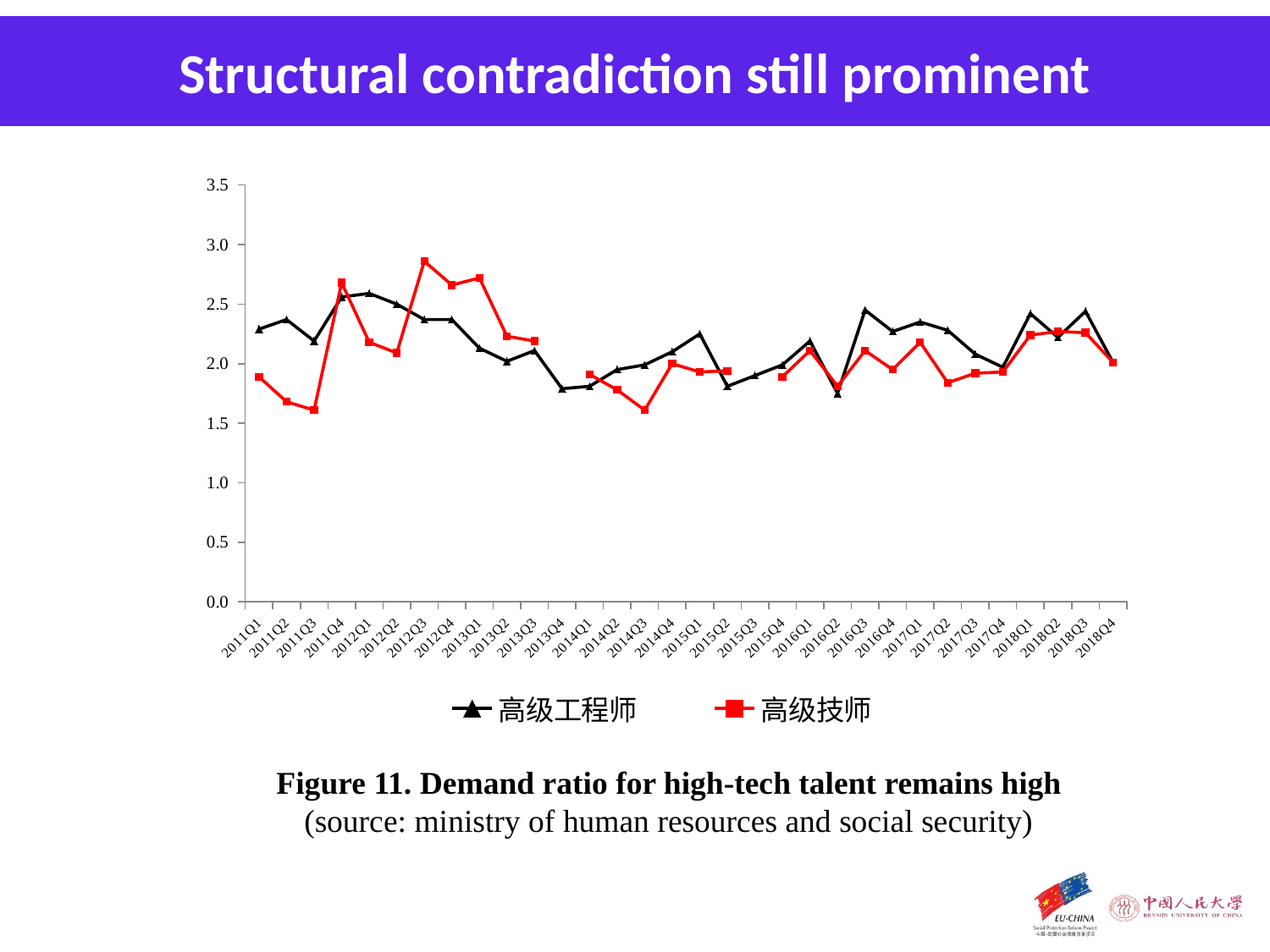
In which quarter does the 高级技师 series reach its highest value? 2012Q3 How many quarters are plotted along the x axis? 32 What is the highest value shown on the y axis? 3.5 What kind of chart is shown on the slide? line chart Is the value for 高级工程师 in 2013Q4 greater or less than 2.0? less How many series does the legend list? 2 Is the value for 高级工程师 in 2012Q1 greater or less than 2.5? greater Is the value for 高级技师 in 2012Q3 greater or less than 2.5? greater Does the 高级技师 series rise or fall from 2011Q3 to 2012Q3? rise In 2011Q1, which series has the higher value, 高级工程师 or 高级技师? 高级工程师 In 2012Q3, which series has the higher value, 高级工程师 or 高级技师? 高级技师